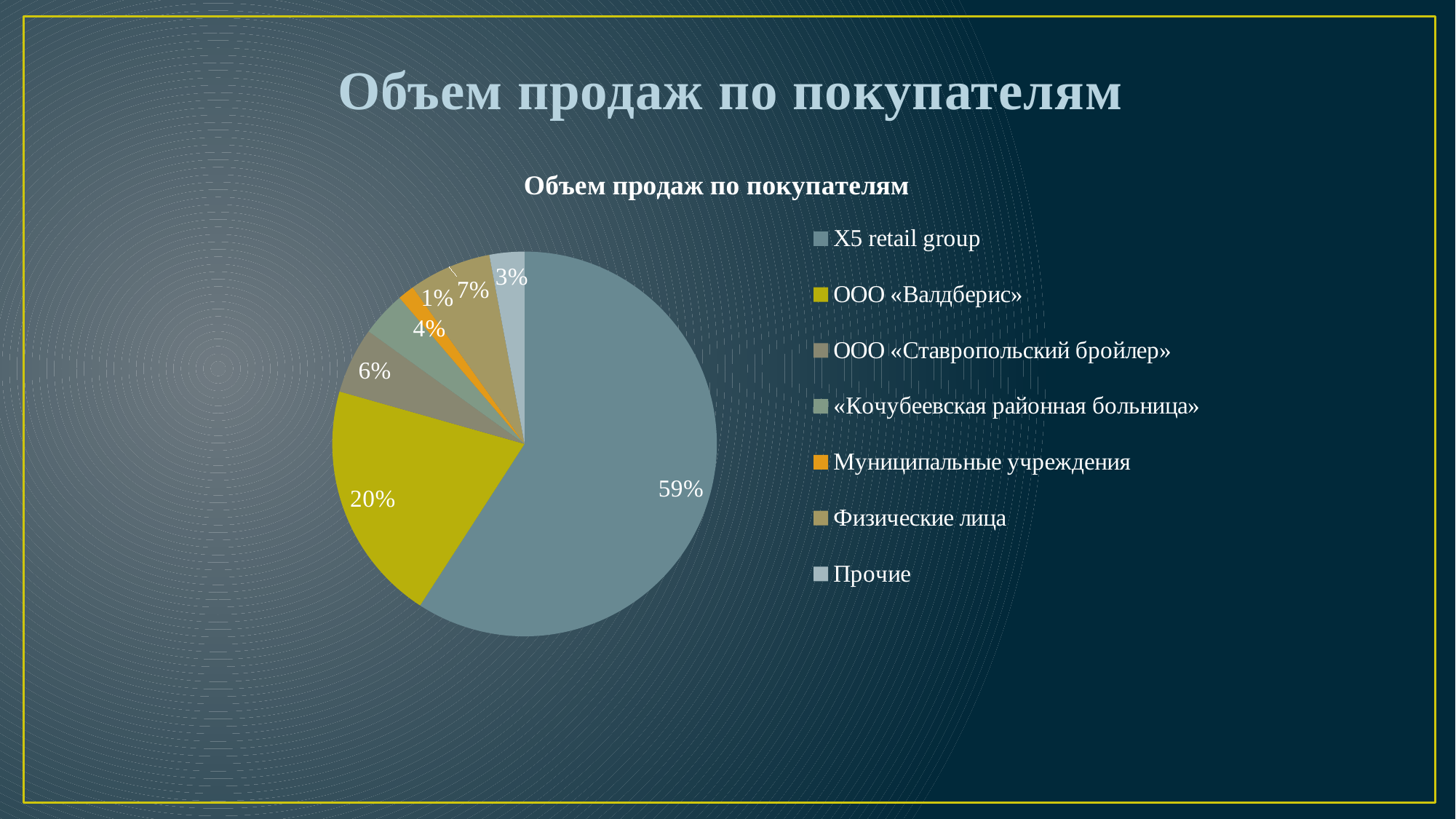
What share of sales does X5 retail group account for? 59% What share of sales does ООО «Ставропольский бройлер» account for? 6% What is the difference in percentage points between the shares of X5 retail group and ООО «Валдберис»? 39 What share of sales do Физические лица account for? 7% What share of sales does ООО «Валдберис» account for? 20% Which buyer has the largest share of sales? X5 retail group What kind of chart is shown on the slide? pie chart Which buyer has the smallest share of sales? Муниципальные учреждения How many buyer categories does the pie chart show? 7 What share of sales do Муниципальные учреждения account for? 1% Which has a larger share of sales: Физические лица or Прочие? Физические лица What is the title of the chart? Объем продаж по покупателям